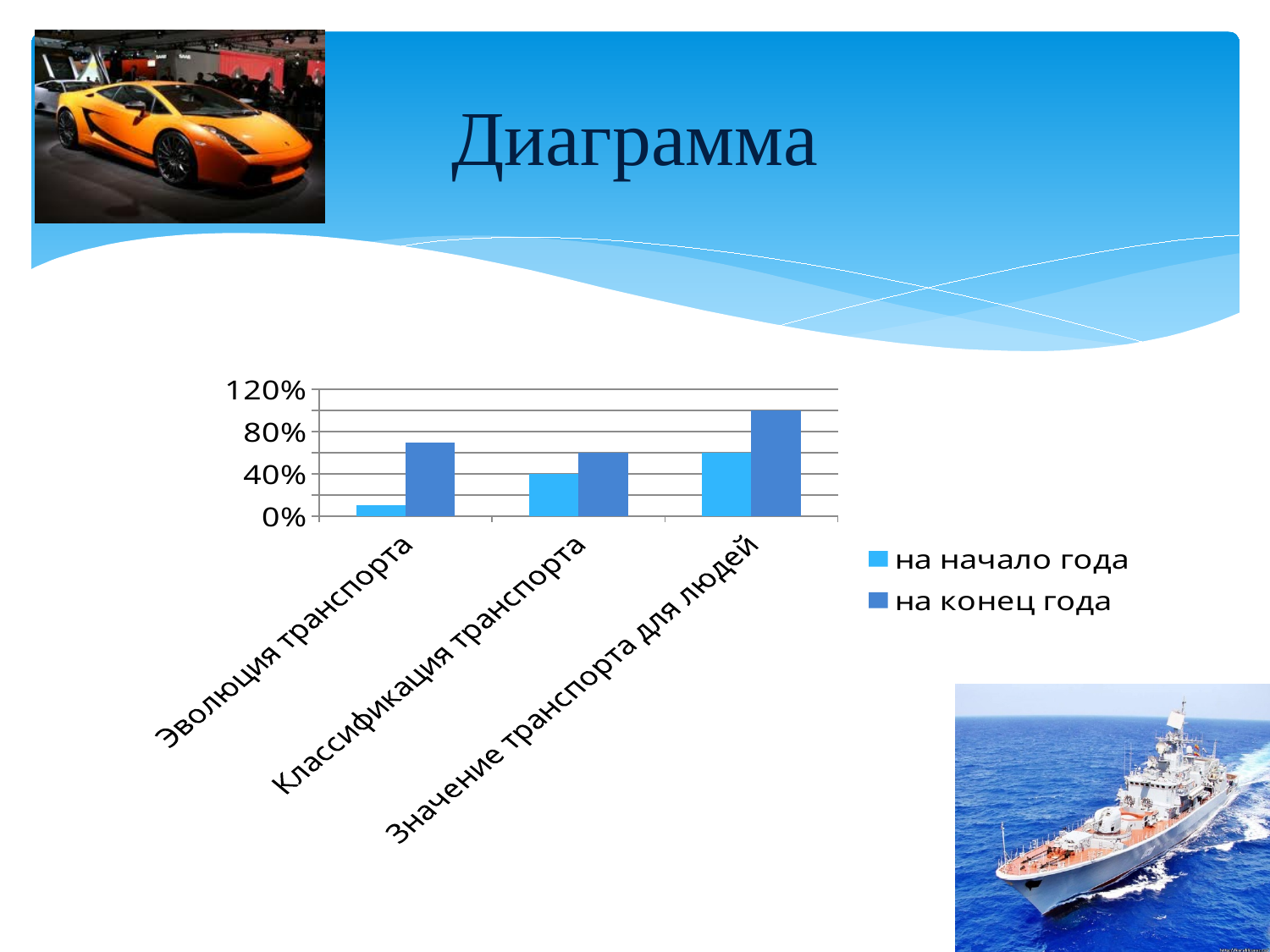
How many series does the chart legend list? 2 For 'Значение транспорта для людей', which is larger: 'на начало года' or 'на конец года'? на конец года What is the value of 'на начало года' for 'Классификация транспорта'? 40% How many categories are shown on the x axis of the chart? 3 Which category has the highest 'на конец года' value? Значение транспорта для людей Is the 'на начало года' value for 'Эволюция транспорта' greater or less than 40%? less Is the 'на конец года' value for 'Эволюция транспорта' greater or less than 40%? greater Which category has the lowest 'на начало года' value? Эволюция транспорта What kind of chart is shown on the slide? bar chart Do the 'на начало года' values rise or fall from left to right across the categories? rise Is the 'на конец года' value for 'Значение транспорта для людей' greater or less than 80%? greater What are the two series listed in the chart legend? на начало года, на конец года